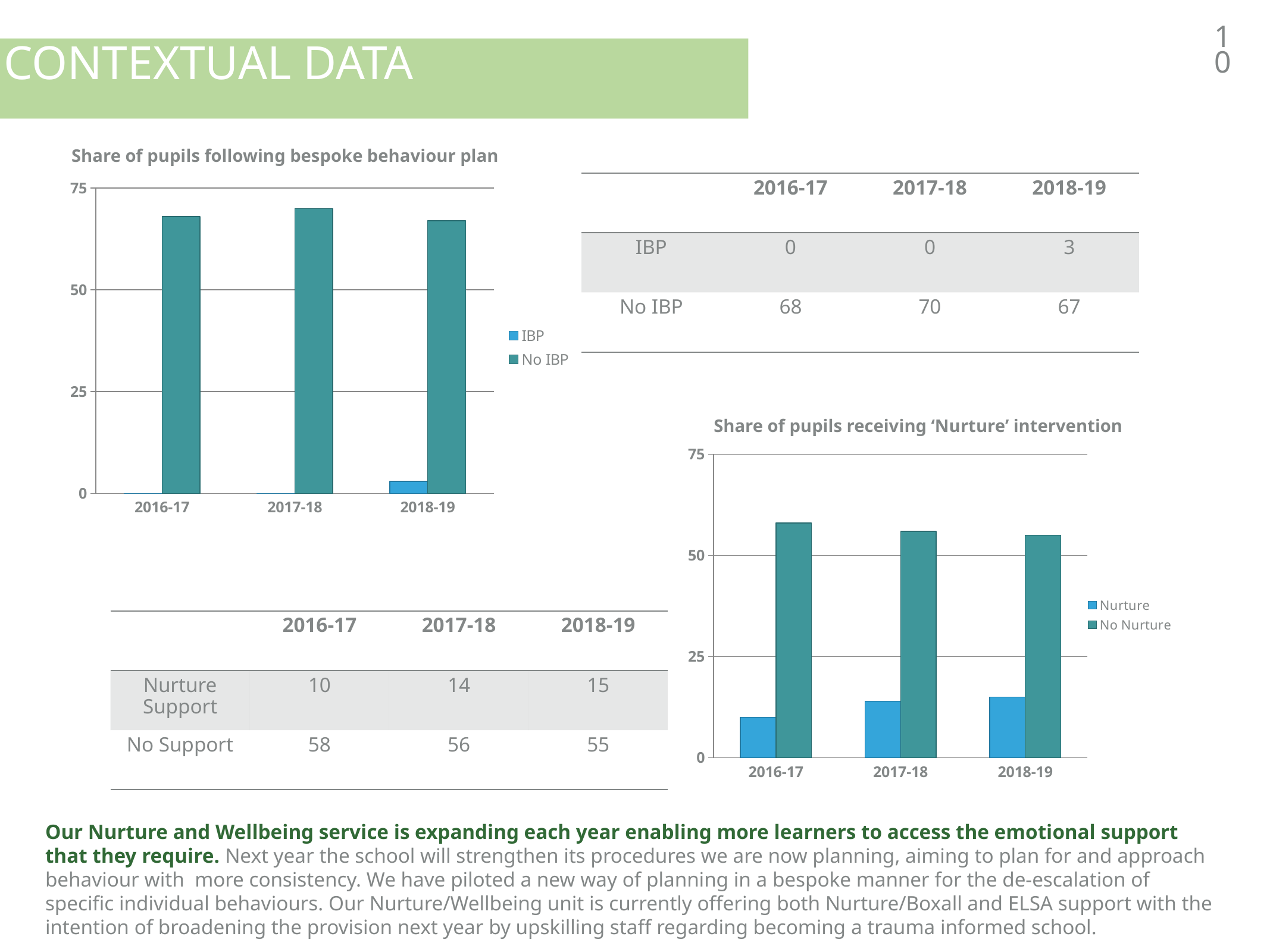
In the 'Share of pupils receiving ‘Nurture’ intervention' chart, which year has the lowest Nurture value? 2016-17 In the 'Share of pupils receiving ‘Nurture’ intervention' chart, is the No Nurture value for 2016-17 greater or less than 50? greater What kind of chart is the 'Share of pupils receiving ‘Nurture’ intervention' chart? bar chart In the 'Share of pupils following bespoke behaviour plan' chart, what is the No IBP value for 2017-18? 70 In the 'Share of pupils receiving ‘Nurture’ intervention' chart, what is the No Nurture value for 2018-19? 55 In the 'Share of pupils receiving ‘Nurture’ intervention' chart, how many years are shown on the x axis? 3 In the 'Share of pupils following bespoke behaviour plan' chart, what is the difference between the No IBP values for 2017-18 and 2018-19? 3 In the 'Share of pupils following bespoke behaviour plan' chart, what is the IBP value for 2018-19? 3 In the 'Share of pupils following bespoke behaviour plan' chart, which year has the highest No IBP value? 2017-18 In the 'Share of pupils receiving ‘Nurture’ intervention' chart, what is the Nurture value for 2017-18? 14 In the 'Share of pupils following bespoke behaviour plan' chart, how many series does the legend list? 2 In the 'Share of pupils receiving ‘Nurture’ intervention' chart, do the Nurture values rise or fall from 2016-17 to 2018-19? rise